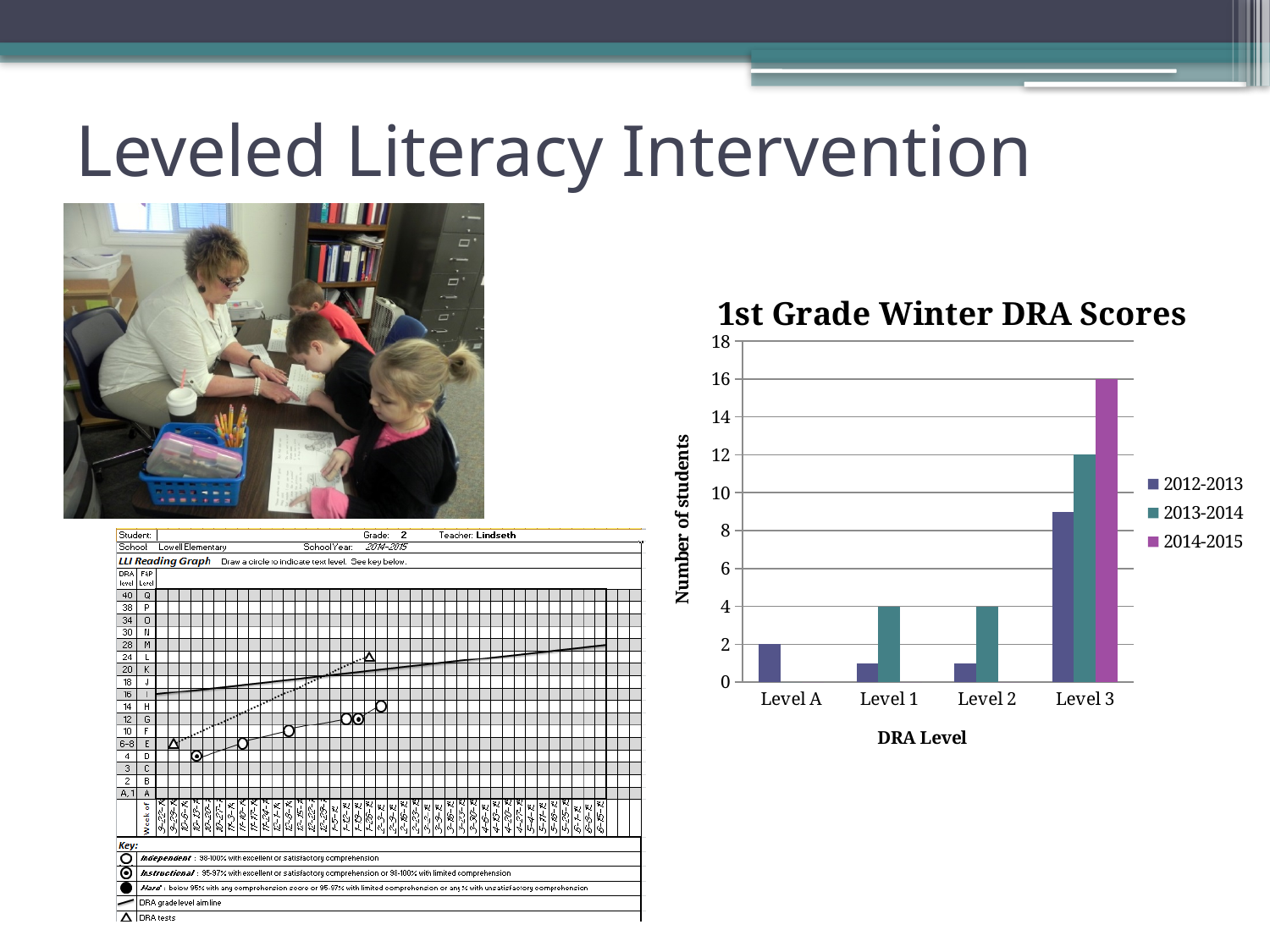
In the "1st Grade Winter DRA Scores" chart, how many students were at Level 3 in 2013-2014? 12 What is the y-axis title of the "1st Grade Winter DRA Scores" chart? Number of students In the "1st Grade Winter DRA Scores" chart, is the 2012-2013 value for Level 1 greater or less than 2? less What kind of chart is the "1st Grade Winter DRA Scores" chart? bar chart How many DRA levels are shown on the x axis of the "1st Grade Winter DRA Scores" chart? 4 In the "1st Grade Winter DRA Scores" chart, what is the difference between the 2014-2015 and 2013-2014 values at Level 3? 4 In the "1st Grade Winter DRA Scores" chart, how many students were at Level 3 in 2014-2015? 16 In the "1st Grade Winter DRA Scores" chart, how many students were at Level A in 2012-2013? 2 In the "1st Grade Winter DRA Scores" chart, how many students were at Level 1 in 2013-2014? 4 In the "1st Grade Winter DRA Scores" chart, which school year has the tallest bar at Level 3? 2014-2015 How many series does the legend of the "1st Grade Winter DRA Scores" chart list? 3 In the "1st Grade Winter DRA Scores" chart, is the 2012-2013 value for Level 3 greater or less than 6? greater